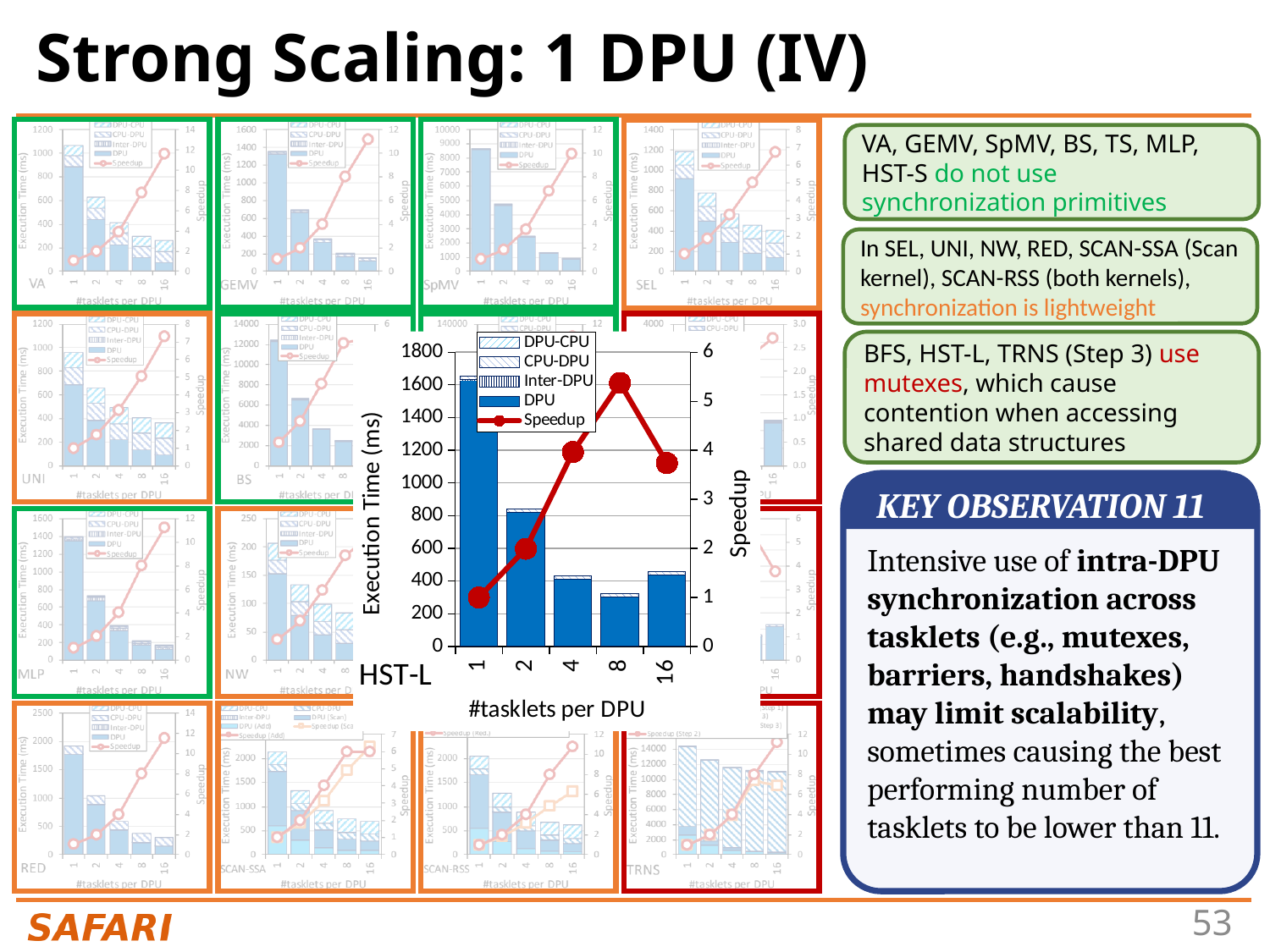
In the HST-L chart, at which number of tasklets per DPU is the speedup highest? 8 In the HST-L chart, at which number of tasklets per DPU is the total execution time highest? 1 In the HST-L chart, what kind of chart is it? A combined bar and line chart In the HST-L chart, what is the speedup at 1 tasklet per DPU? 1 In the HST-L chart, how many values of #tasklets per DPU are shown on the x axis? 5 In the HST-L chart, what is the label of the right-hand y axis? Speedup In the HST-L chart, is the total execution time at 8 tasklets per DPU greater or less than 400 ms? less In the HST-L chart, at which number of tasklets per DPU is the total execution time lowest? 8 In the HST-L chart, how many series does the legend list? 5 In the HST-L chart, which has the larger speedup: 8 tasklets per DPU or 16 tasklets per DPU? 8 tasklets per DPU In the HST-L chart, is the speedup at 8 tasklets per DPU greater or less than 5? greater In the HST-L chart, is the total execution time at 1 tasklet per DPU greater or less than 1600 ms? greater